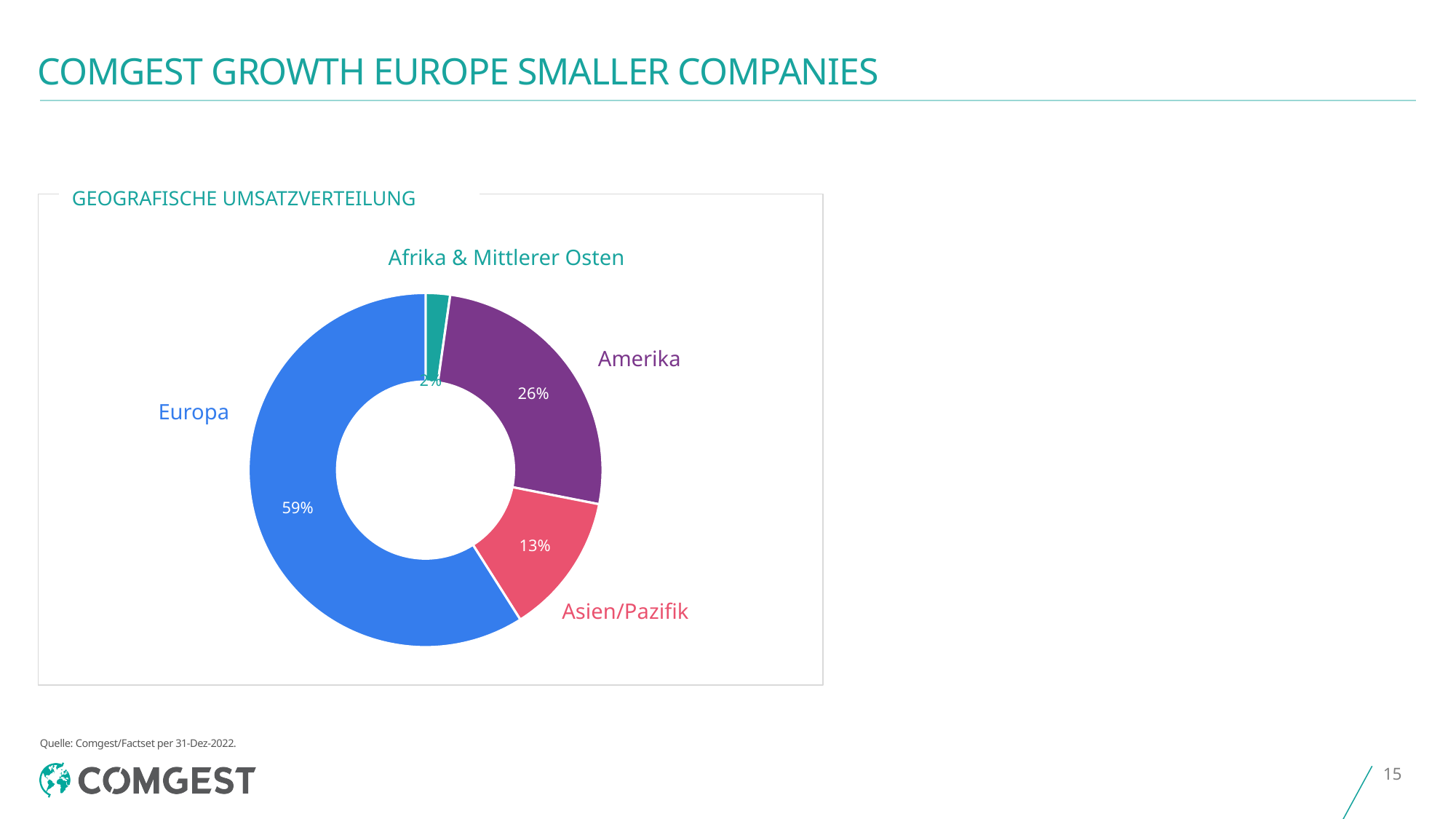
What is the difference in percentage points between Europa and Amerika? 33 What share of revenue does Europa account for in the Geografische Umsatzverteilung chart? 59% What is the title of the chart? GEOGRAFISCHE UMSATZVERTEILUNG How many regions are shown in the chart? 4 What is the value shown for Amerika? 26% What kind of chart is shown on the slide? Pie chart (donut) Which is larger, the share for Amerika or the share for Asien/Pazifik? Amerika Which region has the largest share in the chart? Europa Which region has the smallest share in the chart? Afrika & Mittlerer Osten What percentage is shown for Asien/Pazifik? 13% What is the value for Afrika & Mittlerer Osten? 2% What is the difference in percentage points between Amerika and Asien/Pazifik? 13